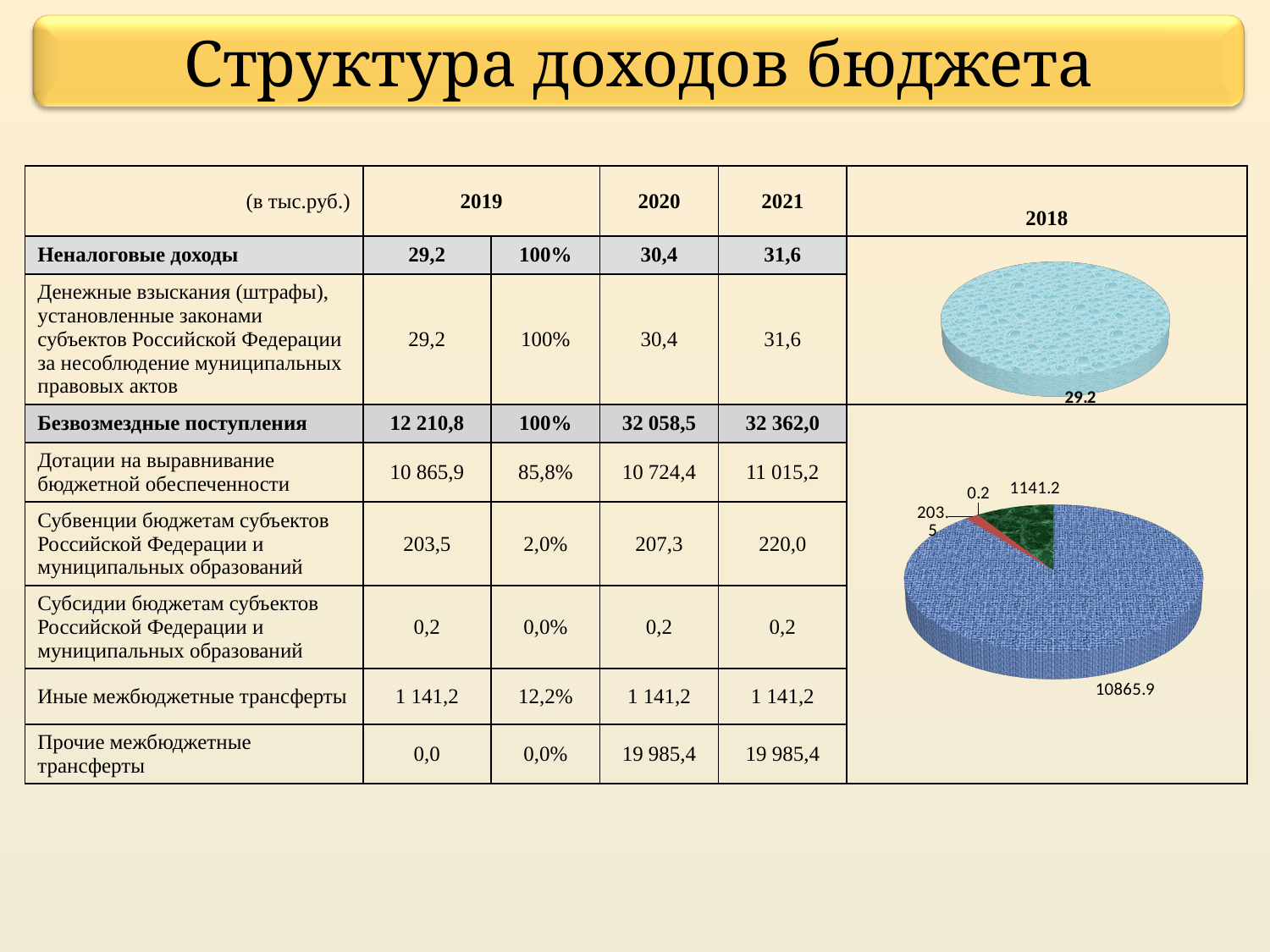
How many slices are labelled in the lower pie chart? 4 How many charts are shown on the slide? 2 In the lower pie chart, what is the value of the largest slice? 10865.9 What is the total of all the slice values printed on the lower pie chart? 12210.8 What kind of chart is the upper chart on the right side of the slide, labelled 2018? pie chart What value is printed on the upper pie chart labelled 2018? 29.2 In the lower pie chart, what is the value of the smallest slice? 0.2 In the lower pie chart, what is the difference between the slice labelled 10865.9 and the slice labelled 1141.2? 9724.7 What colour is the largest slice of the lower pie chart? blue In the lower pie chart, which slice is larger: the one labelled 1141.2 or the one labelled 203.5? 1141.2 What kind of chart is the lower chart on the right side of the slide? pie chart